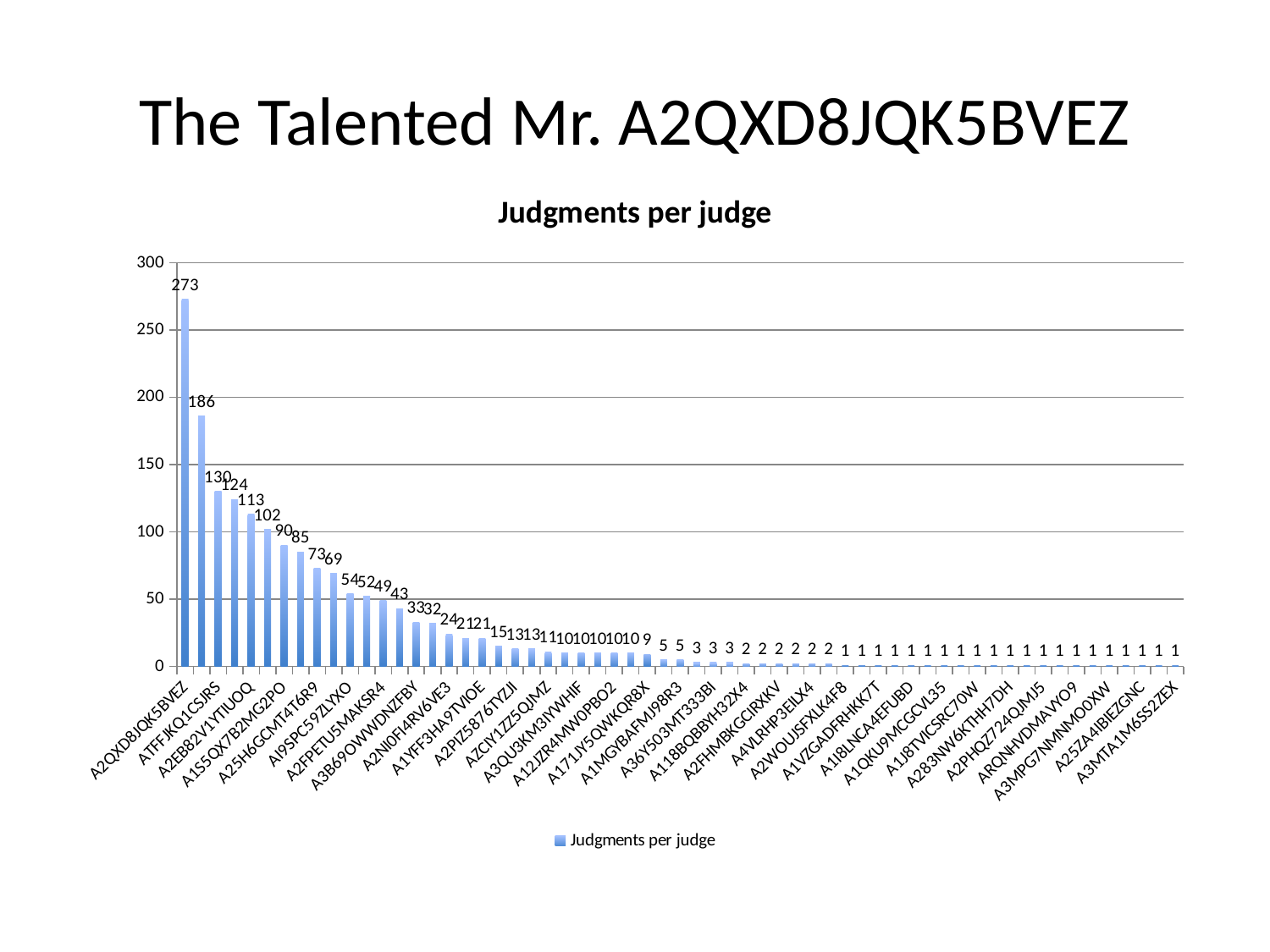
How many judgments does judge A2QXD8JQK5BVEZ have? 273 How many judgments does judge A3MTA1M6SS2ZEX have? 1 What is the value of the second-highest bar in the chart? 186 What kind of chart is shown on the slide? bar chart How many series does the legend list? 1 Do the values rise or fall moving from left to right along the x axis? fall What is the lowest value shown on any bar in the chart? 1 What is the difference between the highest bar (273) and the second-highest bar (186)? 87 Which judge has the highest number of judgments? A2QXD8JQK5BVEZ Is the value for A2QXD8JQK5BVEZ greater or less than 250? greater What is the title of the chart? Judgments per judge What is the legend entry shown below the chart? Judgments per judge